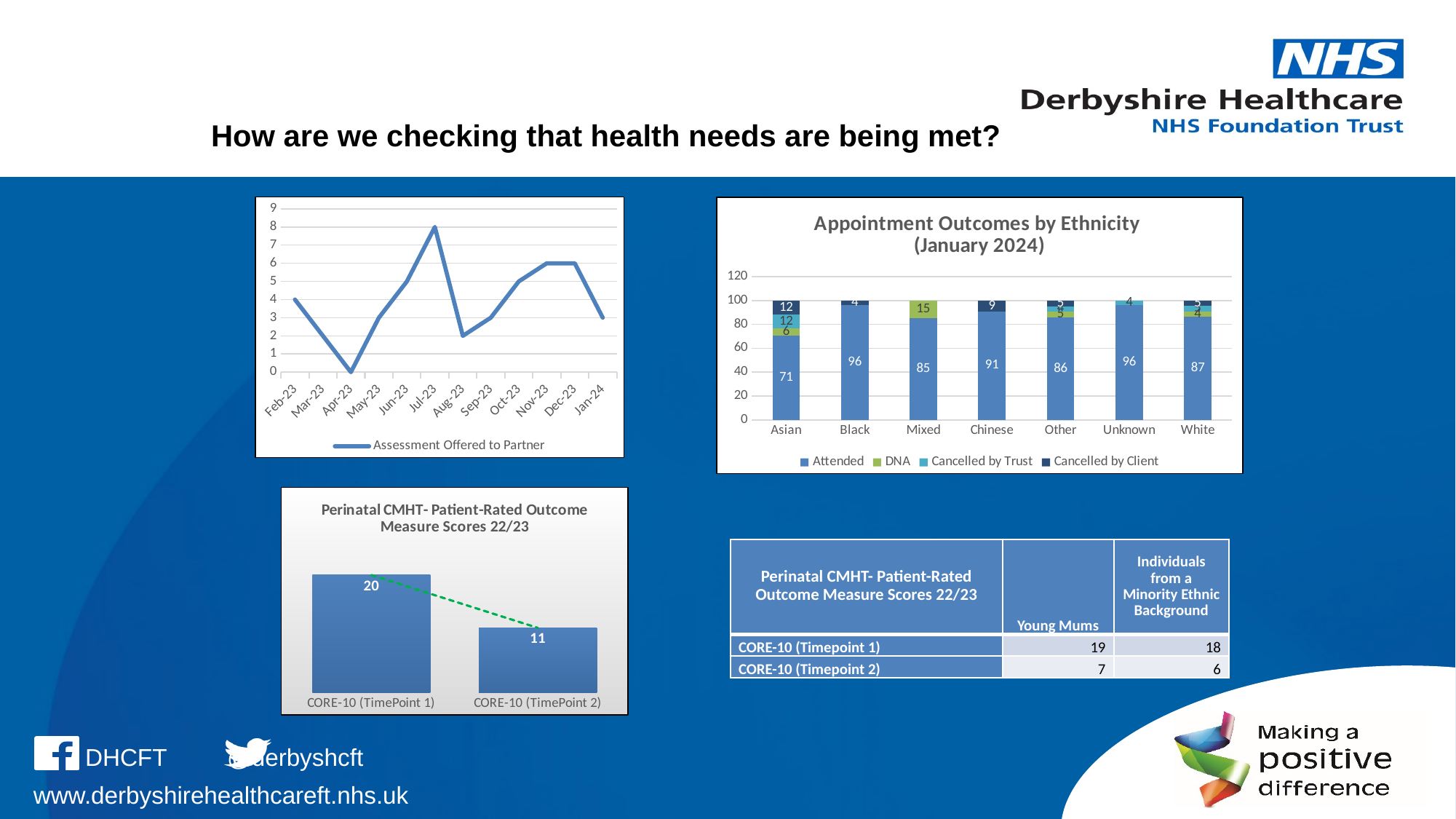
In the Appointment Outcomes by Ethnicity chart, which ethnicity has the lowest Attended value? Asian In the Appointment Outcomes by Ethnicity chart, what is the difference between the Attended values for Chinese and Mixed? 6 In the Appointment Outcomes by Ethnicity chart, how many series does the legend list? 4 In the Perinatal CMHT- Patient-Rated Outcome Measure Scores 22/23 chart, what is the difference between CORE-10 (TimePoint 1) and CORE-10 (TimePoint 2)? 9 In the Perinatal CMHT- Patient-Rated Outcome Measure Scores 22/23 chart, what is the value for CORE-10 (TimePoint 2)? 11 In the top-left line chart, in which month is Assessment Offered to Partner lowest? Apr-23 In the Appointment Outcomes by Ethnicity chart, how many ethnicity categories are shown? 7 In the Appointment Outcomes by Ethnicity chart, what is the DNA value for Mixed? 15 In the Appointment Outcomes by Ethnicity chart, what is the Attended value for Asian? 71 In the top-left line chart, what is the value of Assessment Offered to Partner in Jul-23? 8 What type of chart is the top-left chart showing Assessment Offered to Partner? Line chart In the top-left line chart, in which month does Assessment Offered to Partner reach its highest value? Jul-23